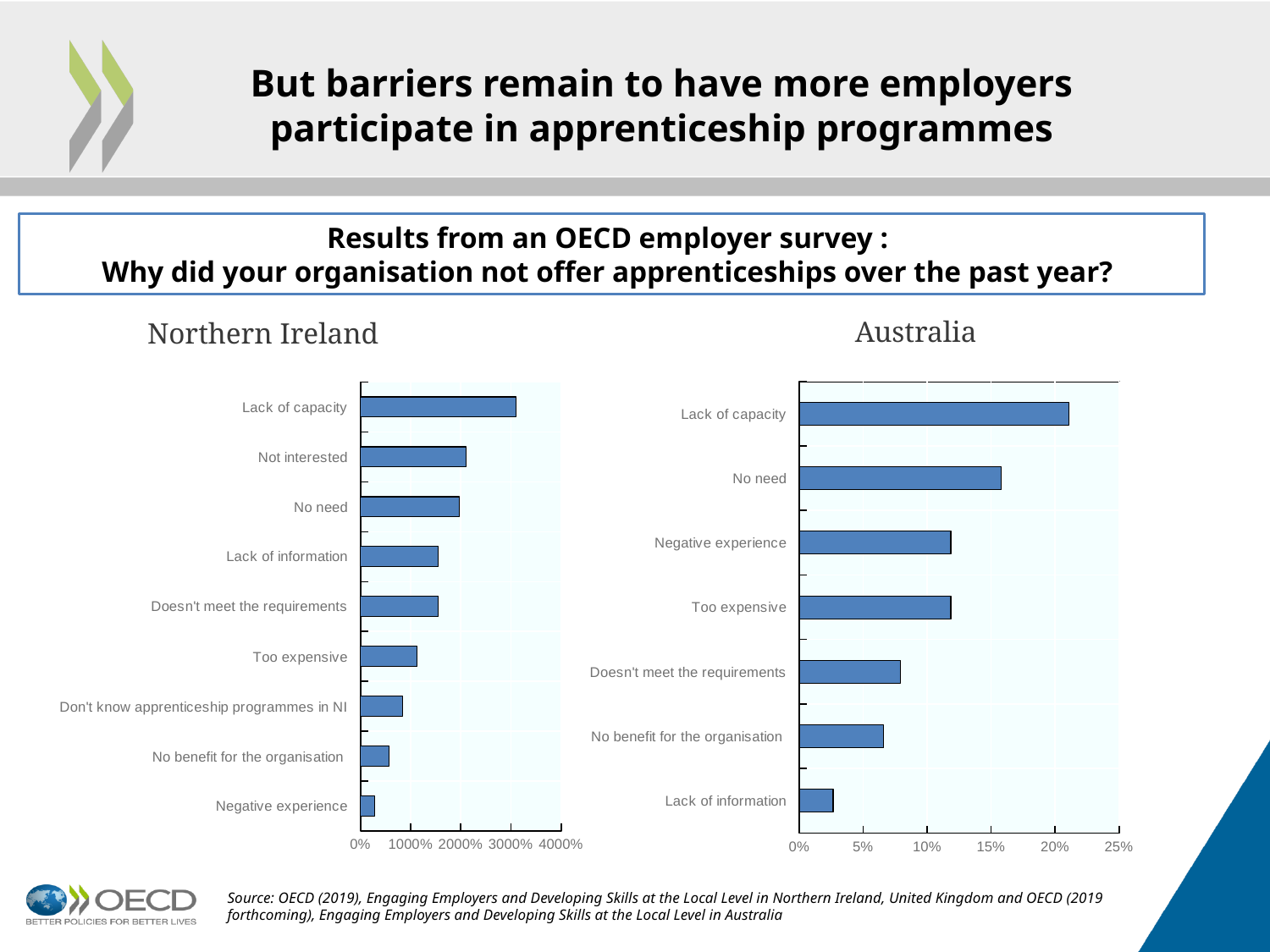
In the Northern Ireland chart, is the value for Lack of capacity greater or less than 3000%? greater In the Australia chart, which category has the highest value? Lack of capacity In the Australia chart, is the value for Lack of information greater or less than 5%? less In the Northern Ireland chart, is the value for Negative experience greater or less than 1000%? less In the Australia chart, which is larger, the value for No need or the value for Too expensive? No need In the Australia chart, which category has the lowest value? Lack of information In the Northern Ireland chart, which category has the lowest value? Negative experience What kind of chart is the Australia chart? Bar chart In the Northern Ireland chart, which category has the highest value? Lack of capacity How many categories are shown in the Northern Ireland chart? 9